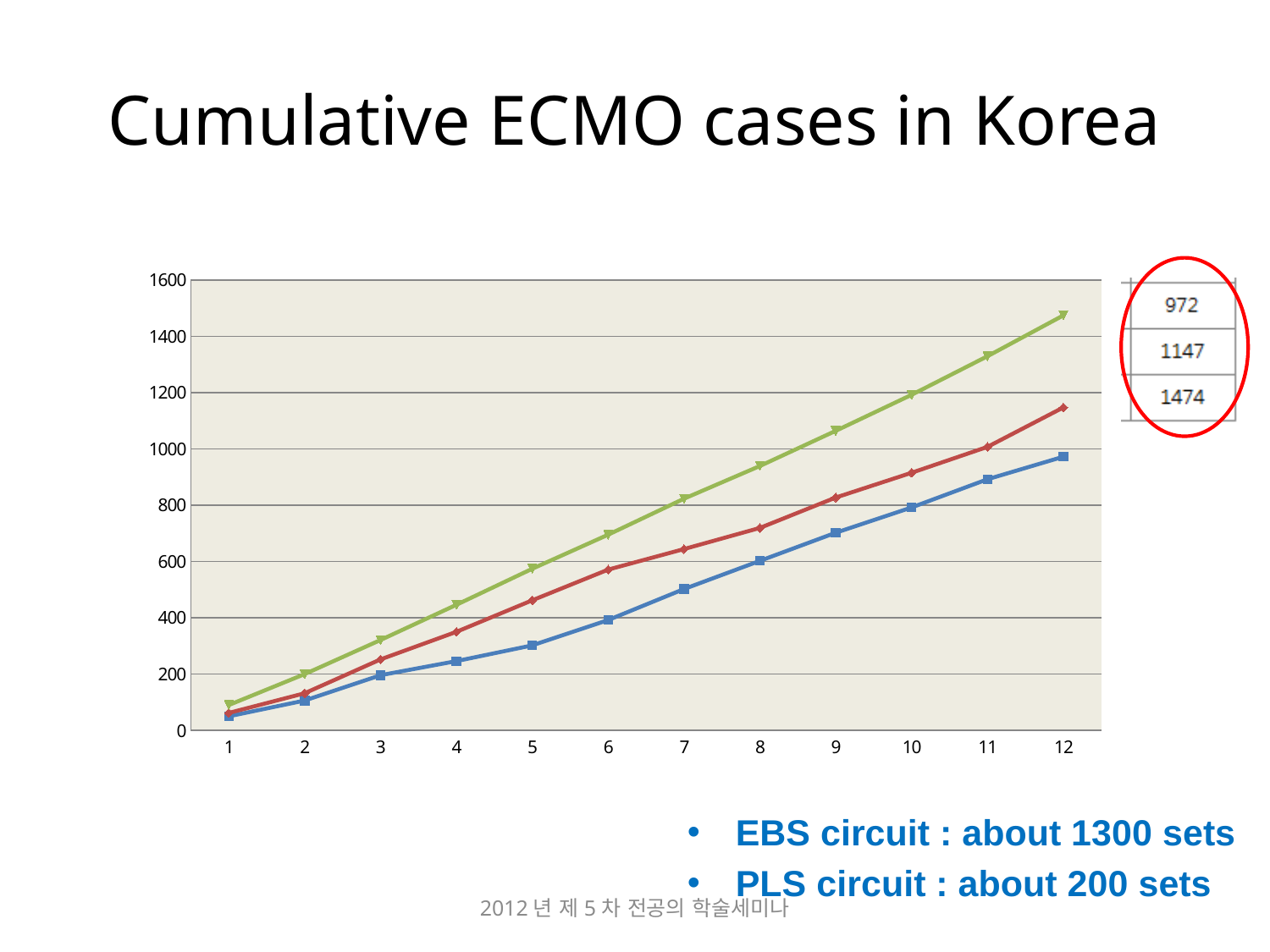
What is the largest value listed in the circled table to the right of the chart? 1474 How many lines are plotted on the chart? 3 Which line is highest at x = 12: the green, red or blue line? green How many points are labelled along the x axis of the chart? 12 Is the value of the blue line at x = 12 greater or less than 1000? less Do the values of the lines rise or fall from x = 1 to x = 12? rise Is the value of the green line at x = 12 greater or less than 1400? greater Which line is lowest at x = 12: the green, red or blue line? blue Is the value of the red line at x = 6 greater or less than 600? less What is the title of the slide containing the chart? Cumulative ECMO cases in Korea Which is larger at x = 9: the value of the green line or the value of the blue line? green line What kind of chart is shown on the slide? line chart